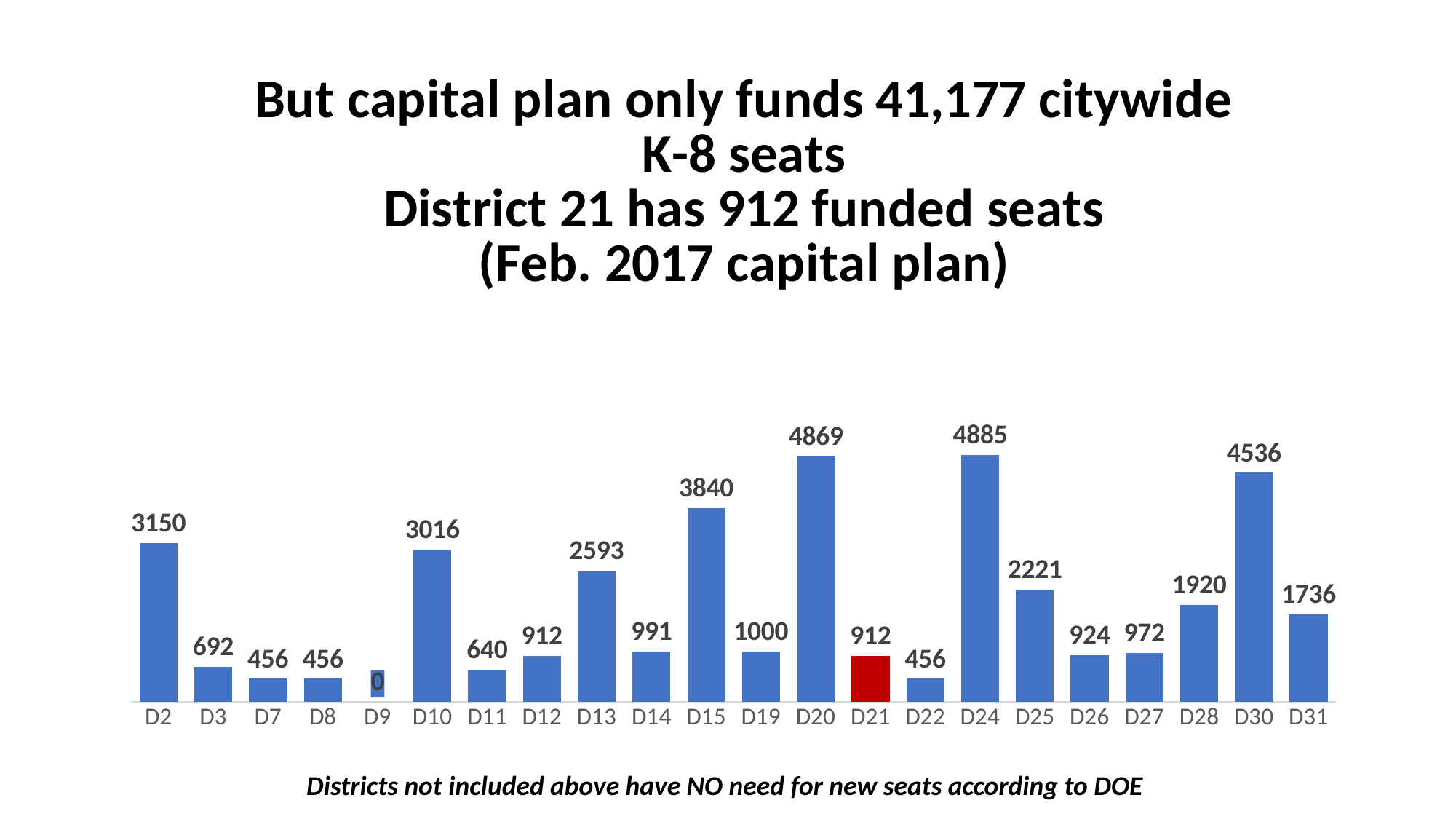
Which district's bar is coloured red? D21 Which district has the highest value? D24 What is the value for D15? 3840 What kind of chart is shown on the slide? Bar chart What is the difference between the values for D20 and D21? 3957 Which district has the lowest value? D9 What is the value for D21? 912 Which is larger, the value for D13 or the value for D25? D13 What is the difference between the values for D2 and D10? 134 How many districts are shown on the x axis? 22 What is the value for D30? 4536 Which two districts both have a value of 456 besides D22? D7 and D8